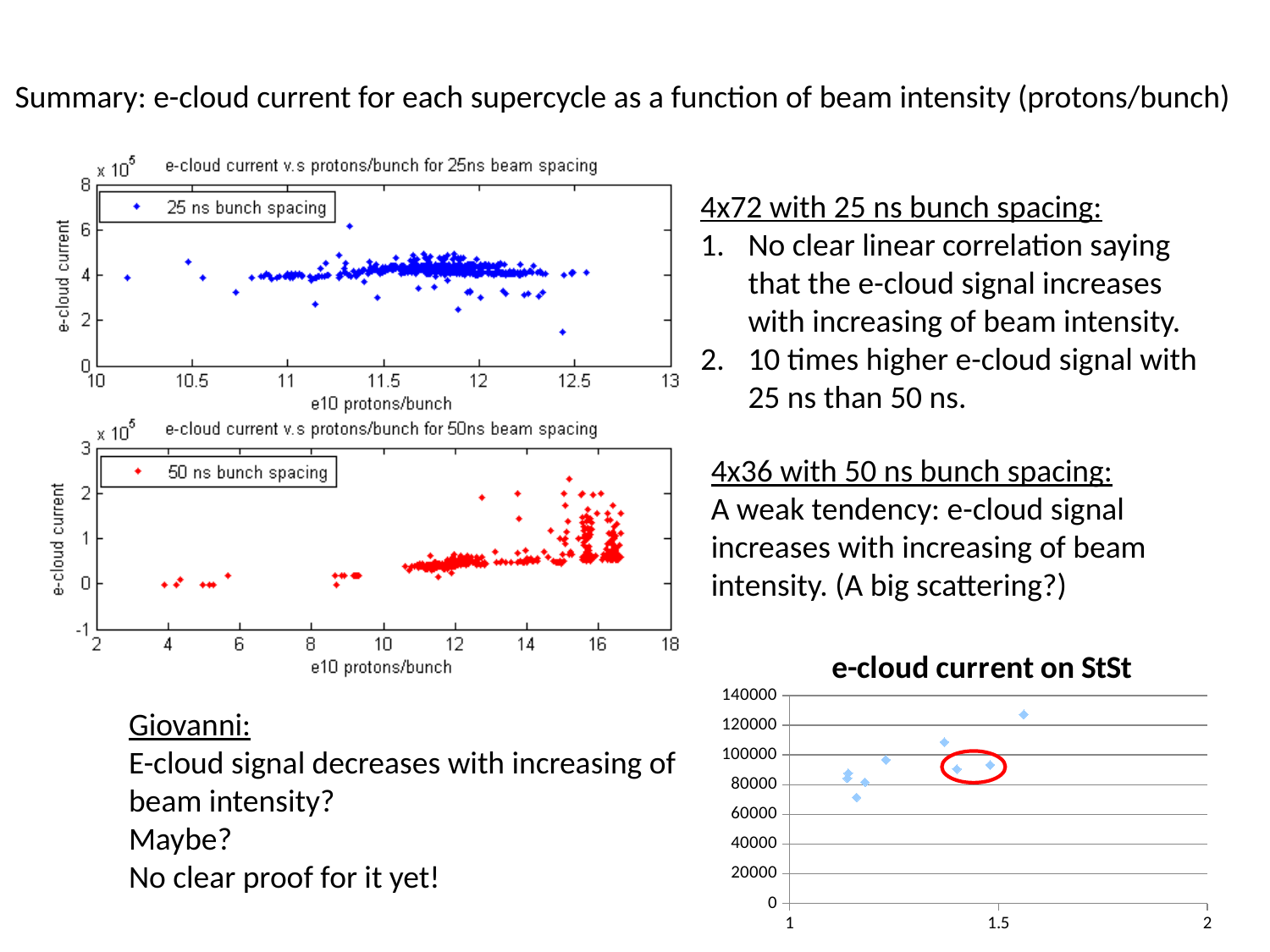
In the top-left chart (25ns beam spacing), is the lowest plotted e-cloud current value greater or less than 2 (x10^5)? less In the middle-left chart (50ns beam spacing), is the highest plotted e-cloud current value greater or less than 2 (x10^5)? greater In the chart "e-cloud current on StSt", is the lowest plotted value greater or less than 80000? less What kind of chart is the bottom-right chart titled "e-cloud current on StSt"? scatter chart What colour are the data points in the middle-left chart (50ns beam spacing)? red In the middle-left chart (50ns beam spacing), do the e-cloud current values generally rise or fall as protons/bunch increases? rise How many series does the legend of the top-left chart (25ns beam spacing) list? 1 What is the highest tick value on the x axis of the middle-left chart (50ns beam spacing)? 18 What is the legend entry shown in the top-left chart (25ns beam spacing)? 25 ns bunch spacing What kind of chart is the top-left chart titled "e-cloud current v.s protons/bunch for 25ns beam spacing"? scatter chart In the chart "e-cloud current on StSt", do the values generally rise or fall along the x axis? rise